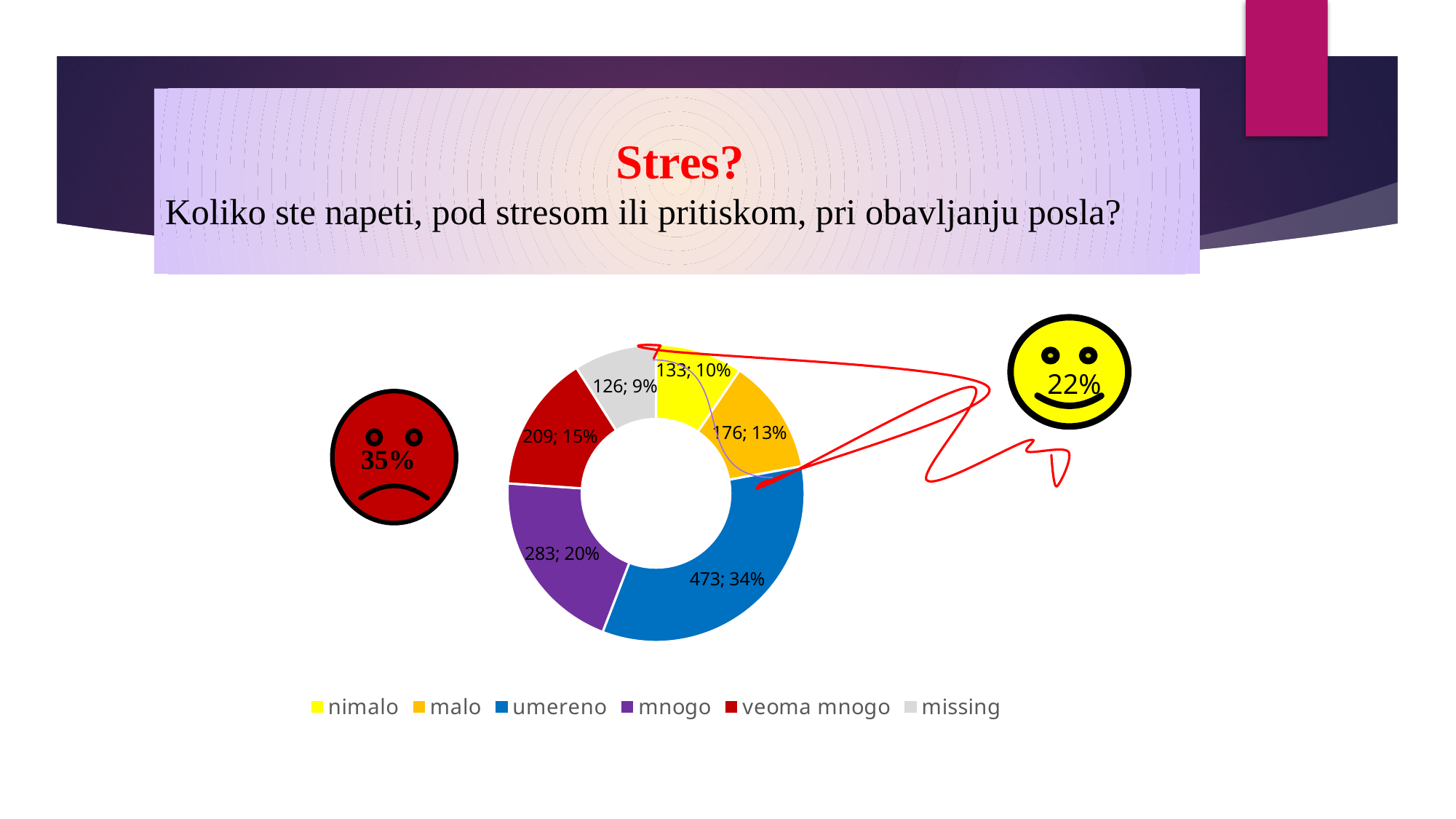
Which category has the largest share of the chart? umereno What is the total of all counts shown in the chart? 1400 How many categories does the chart show? 6 What kind of chart is shown on the slide? doughnut chart What percentage share does the 'nimalo' category have? 10% Which category has the smallest share of the chart? missing What is the count for the 'veoma mnogo' category? 209 What is the count for the 'umereno' category? 473 What is the difference between the counts for 'umereno' and 'mnogo'? 190 Which colour represents the 'missing' category in the legend? grey Which has a larger count, 'malo' or 'veoma mnogo'? veoma mnogo What percentage share does the 'mnogo' category have? 20%